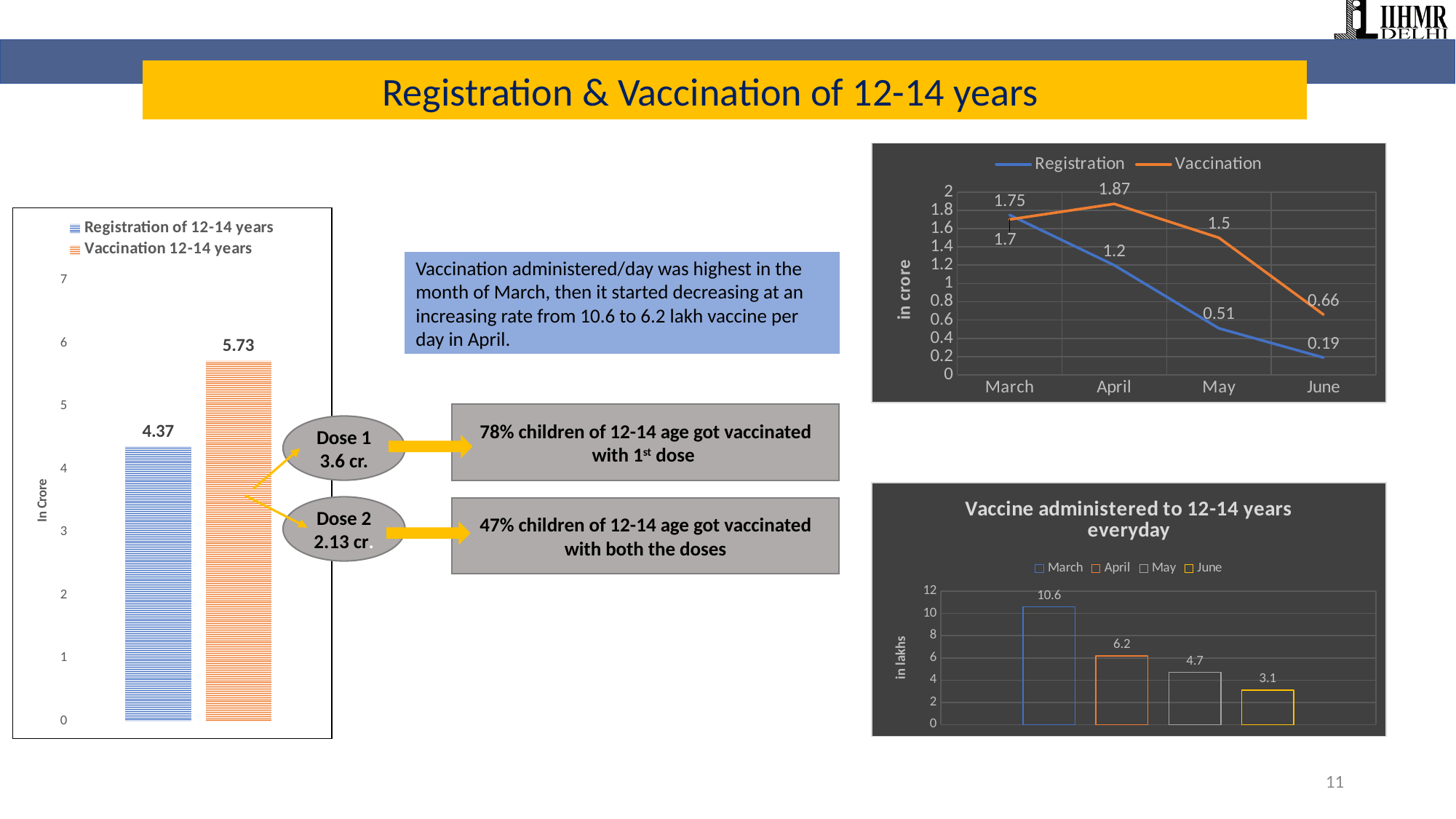
In the top-right line chart, in which month is the Vaccination value highest? April In the left bar chart, what is the value for Vaccination 12-14 years? 5.73 In the chart titled 'Vaccine administered to 12-14 years everyday', what is the value for March? 10.6 In the top-right line chart, how many series does the legend list? 2 In the chart titled 'Vaccine administered to 12-14 years everyday', what is the difference between the March and April values? 4.4 In the top-right line chart, does the Registration series rise or fall from March to June? fall In the left bar chart, what is the value for Registration of 12-14 years? 4.37 In the top-right line chart, what is the Registration value for June? 0.19 In the top-right line chart, what is the Vaccination value for April? 1.87 What kind of chart is the chart titled 'Vaccine administered to 12-14 years everyday'? bar chart In the left bar chart, what is the difference between the Vaccination and Registration values? 1.36 In the chart titled 'Vaccine administered to 12-14 years everyday', which month has the lowest value? June